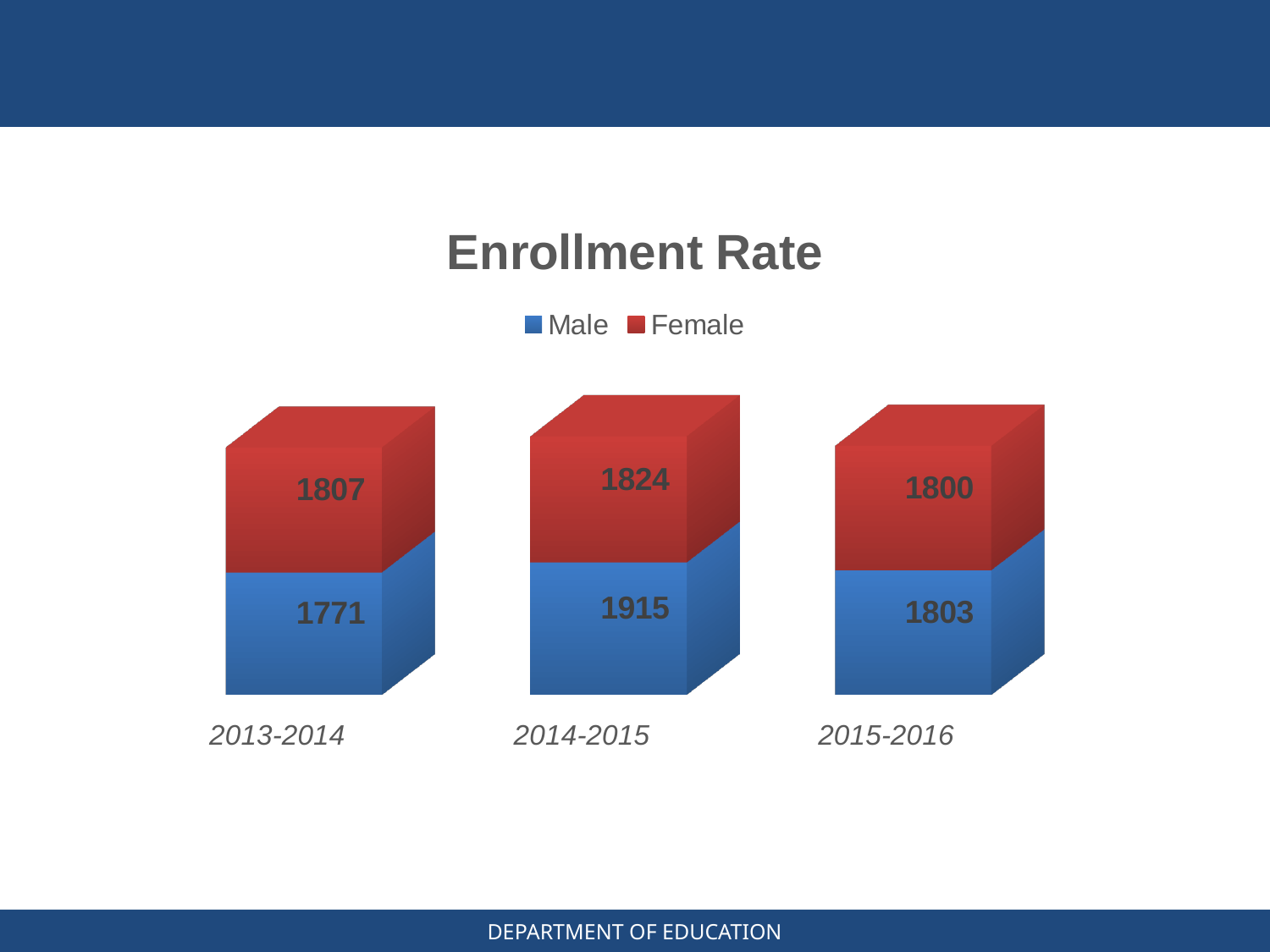
What is the difference between the Male and Female values for 2014-2015? 91 What is the Male value for 2014-2015? 1915 Is the Male value for 2013-2014 larger or smaller than the Female value for 2013-2014? smaller What is the total of the stacked bar for 2013-2014? 3578 Which year has the lowest Female value? 2015-2016 How many years are shown on the x axis? 3 What is the Male value for 2015-2016? 1803 What is the total of the stacked bar for 2015-2016? 3603 What type of chart is shown? Stacked bar chart What is the Female value for 2013-2014? 1807 How many series does the legend list? 2 Which year has the highest Male value? 2014-2015